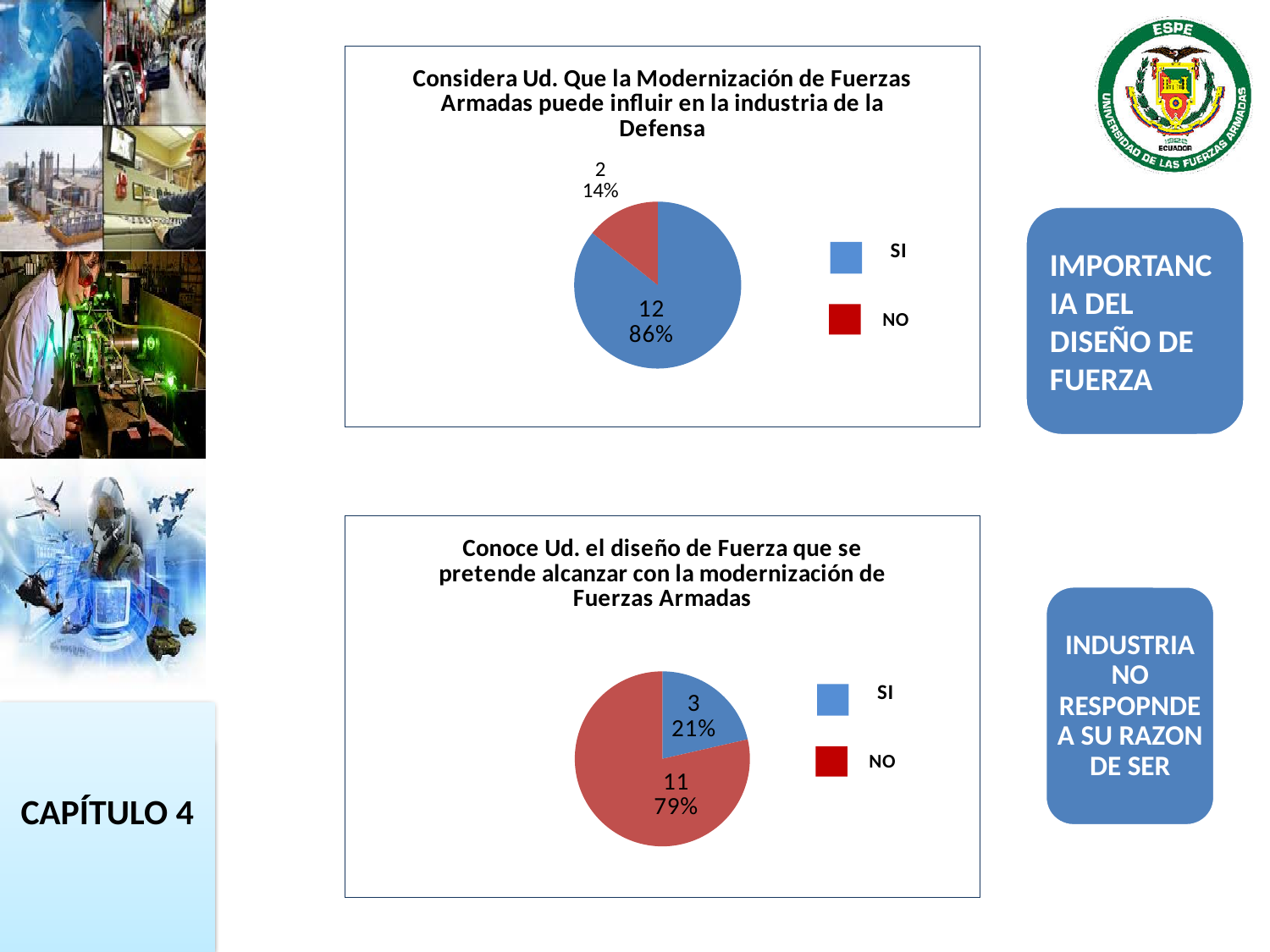
In the bottom chart (Conoce Ud. el diseño de Fuerza que se pretende alcanzar con la modernización de Fuerzas Armadas), what percentage of respondents answered SI? 21% In the top chart (Considera Ud. Que la Modernización de Fuerzas Armadas puede influir en la industria de la Defensa), which answer has the largest slice? SI How many categories does the legend of the bottom chart (Conoce Ud. el diseño de Fuerza que se pretende alcanzar con la modernización de Fuerzas Armadas) list? 2 In the bottom chart (Conoce Ud. el diseño de Fuerza que se pretende alcanzar con la modernización de Fuerzas Armadas), how many respondents answered NO? 11 In the top chart (Considera Ud. Que la Modernización de Fuerzas Armadas puede influir en la industria de la Defensa), how many respondents answered SI? 12 In the top chart (Considera Ud. Que la Modernización de Fuerzas Armadas puede influir en la industria de la Defensa), what colour represents NO? Red In the top chart (Considera Ud. Que la Modernización de Fuerzas Armadas puede influir en la industria de la Defensa), what is the difference between the number of SI and NO responses? 10 In the bottom chart (Conoce Ud. el diseño de Fuerza que se pretende alcanzar con la modernización de Fuerzas Armadas), what is the total number of responses? 14 In the bottom chart (Conoce Ud. el diseño de Fuerza que se pretende alcanzar con la modernización de Fuerzas Armadas), which is larger, the SI count or the NO count? NO In the bottom chart (Conoce Ud. el diseño de Fuerza que se pretende alcanzar con la modernización de Fuerzas Armadas), which answer has the smallest slice? SI In the top chart (Considera Ud. Que la Modernización de Fuerzas Armadas puede influir en la industria de la Defensa), what kind of chart is shown? Pie chart In the top chart (Considera Ud. Que la Modernización de Fuerzas Armadas puede influir en la industria de la Defensa), what percentage of respondents answered NO? 14%